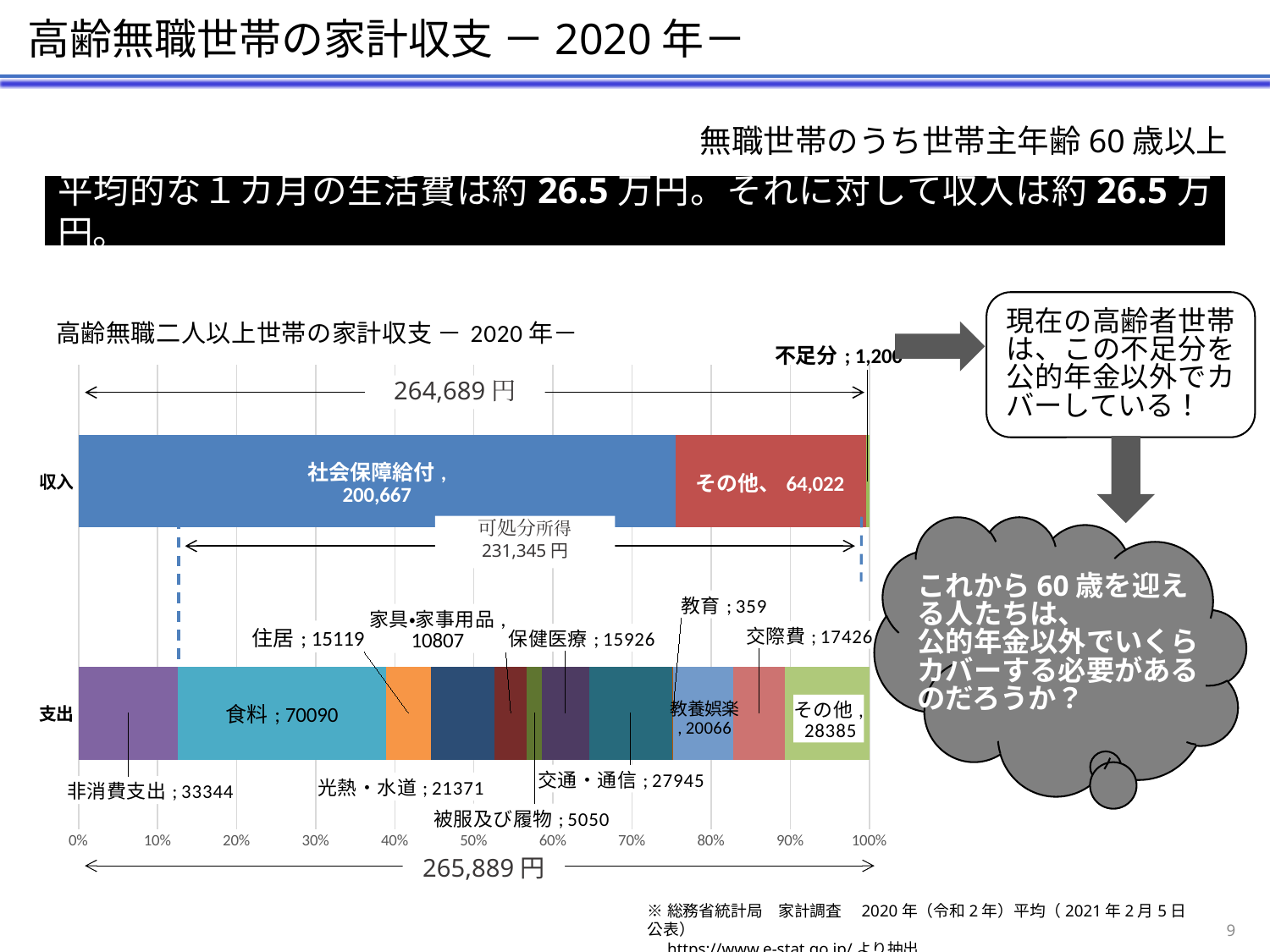
Which segment of the 支出 bar has the smallest value? 教育 Which is larger in the 支出 bar, 住居 or 保健医療? 保健医療 What type of chart is shown on the slide? Stacked bar chart What is the value of その他 in the 収入 bar? 64,022 What is the value of 教育 in the 支出 bar? 359 What is the value of 食料 in the 支出 bar? 70090 What is the value of 交通・通信 in the 支出 bar? 27945 What total is shown for the 支出 bar? 265,889円 What is the title of the chart? 高齢無職二人以上世帯の家計収支 － 2020年－ What is the value of 社会保障給付 in the 収入 bar? 200,667 Which segment of the 支出 bar has the largest value? 食料 What is the difference between 社会保障給付 and その他 in the 収入 bar? 136,645